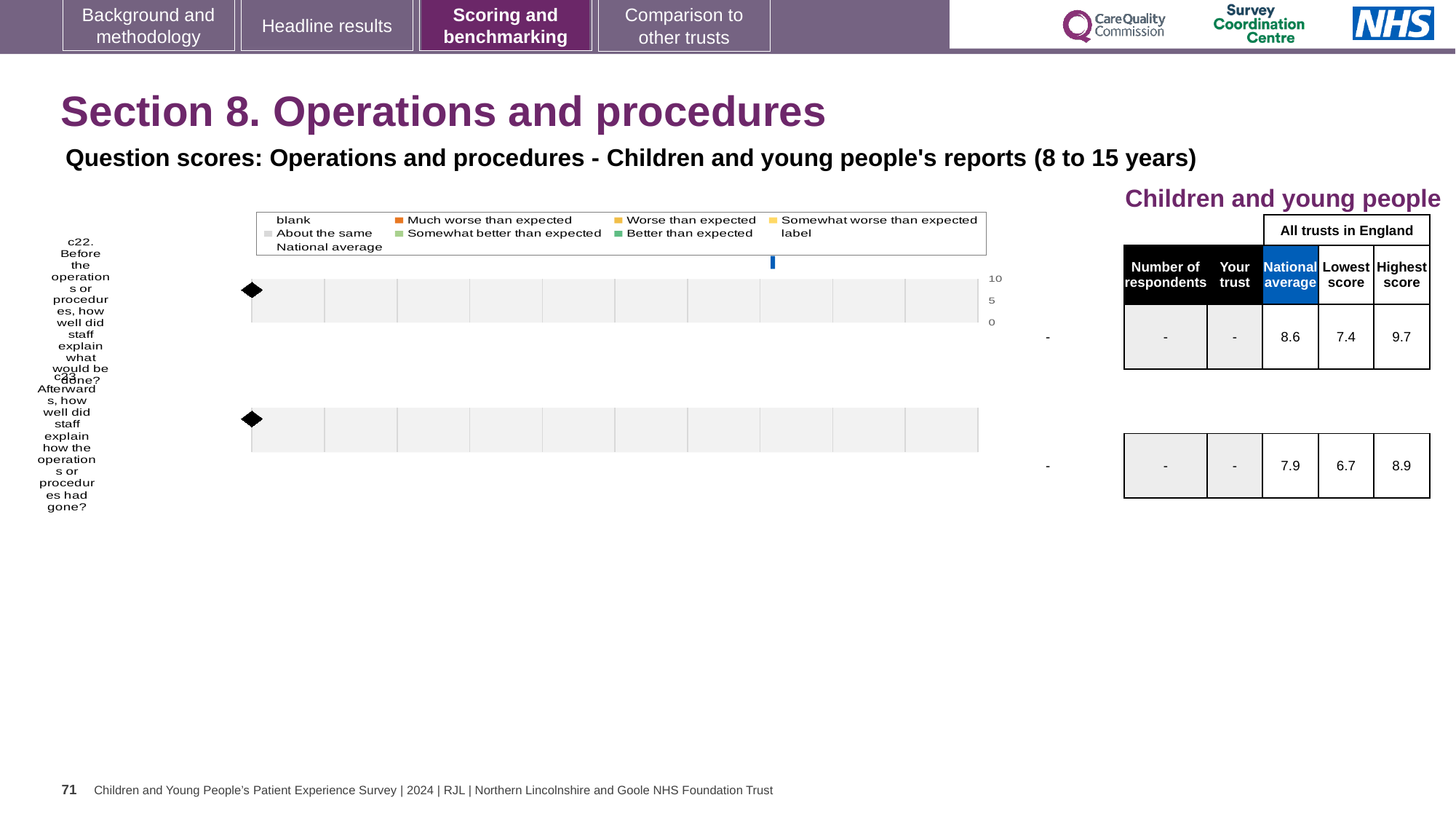
In the table, what value is shown for 'Your trust' for c22? - Which question has the higher national average in the table, c22 or c23? c22 What colour is the legend marker for 'Much worse than expected'? orange How many question categories are plotted on the chart? 2 In the table, what is the lowest score across all trusts in England for c23 (Afterwards, how well did staff explain how the operations or procedures had gone)? 6.7 In the table, what is the highest score across all trusts in England for c22? 9.7 What kind of chart is shown on the slide? bar chart In the table, what is the difference between the highest score and the lowest score for c23? 2.2 What is the highest tick value shown on the chart's value axis? 10 In the table, what is the difference between the highest score and the lowest score for c22? 2.3 In the table, what is the national average score for c22 (Before the operations or procedures, how well did staff explain what would be done)? 8.6 In the table, what is the national average score for c23? 7.9